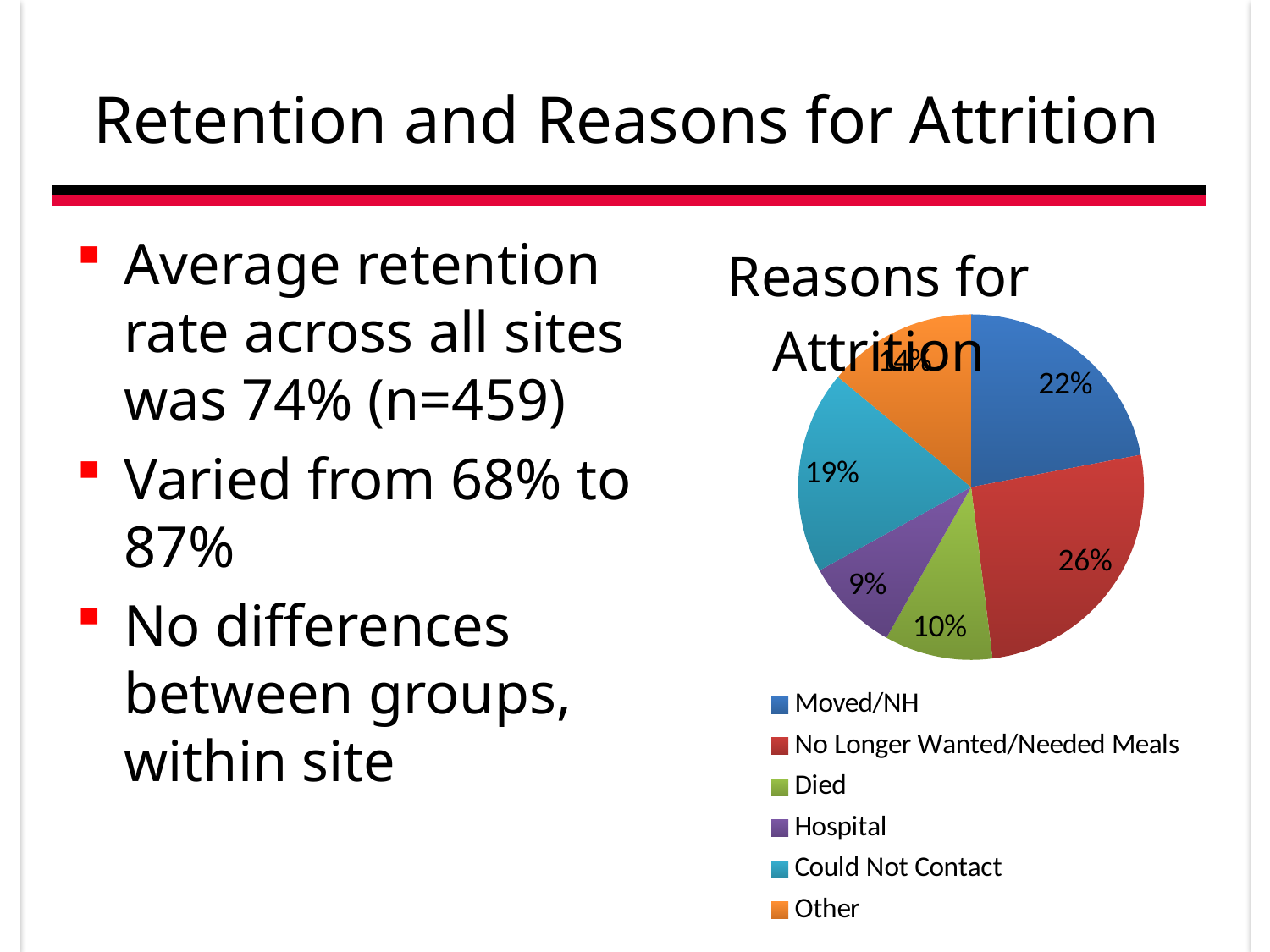
How many percentage points larger is the Moved/NH share than the Could Not Contact share? 3 Which reason for attrition has the smallest share of the pie? Hospital What percentage is shown for Died? 10% What share of the pie is labelled for No Longer Wanted/Needed Meals? 26% What is the title of the chart? Reasons for Attrition What kind of chart is shown on the slide? pie chart What percentage is shown for Hospital? 9% What percentage is shown for Moved/NH? 22% What percentage is shown for Could Not Contact? 19% How many categories does the legend list? 6 Which reason for attrition has the largest share of the pie? No Longer Wanted/Needed Meals Which is larger, the share for Died or the share for Hospital? Died